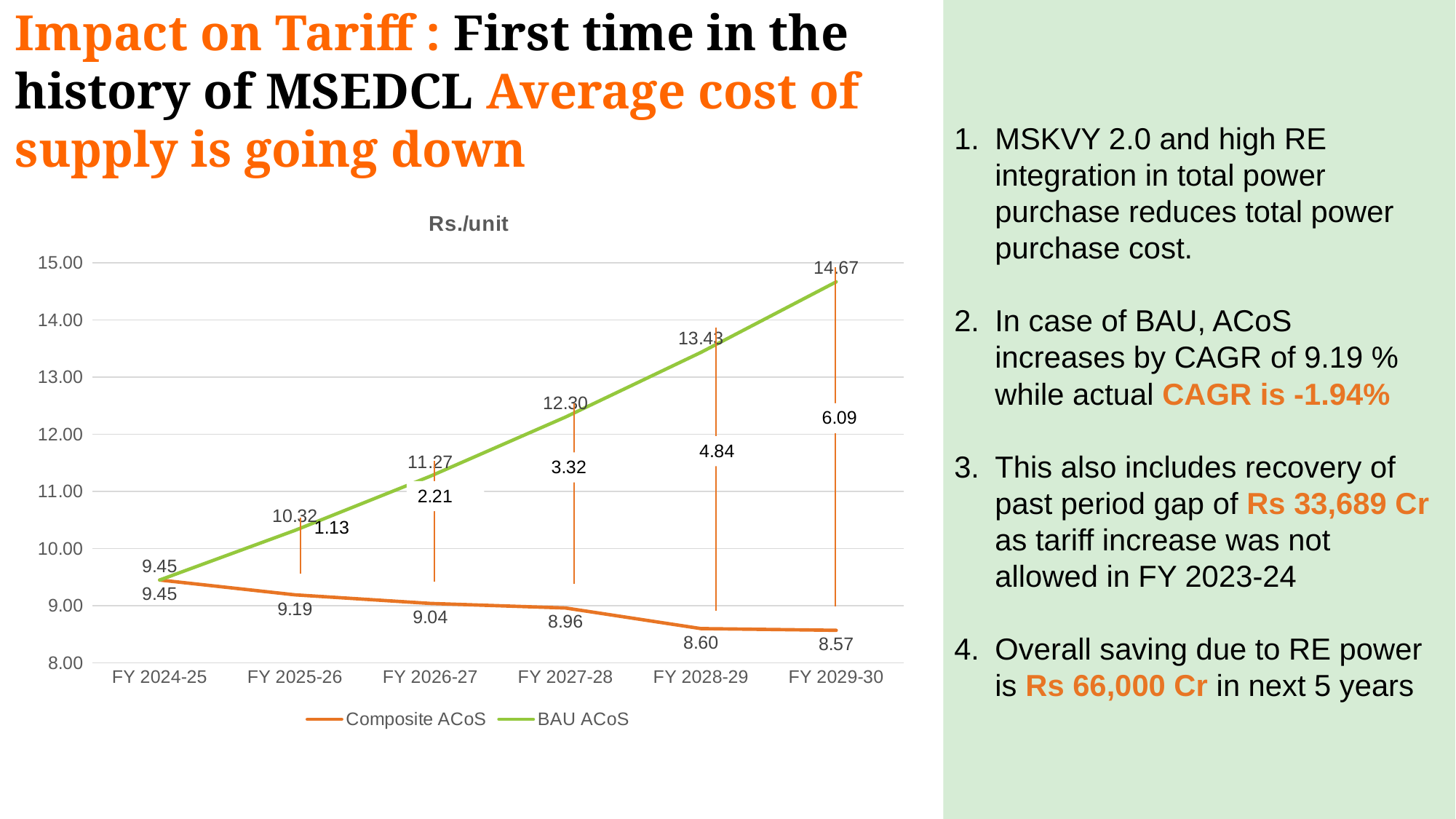
Does the Composite ACoS rise or fall from FY 2024-25 to FY 2029-30? Fall What is the BAU ACoS value for FY 2029-30? 14.67 Which is larger in FY 2025-26, the BAU ACoS or the Composite ACoS? BAU ACoS What is the BAU ACoS value for FY 2026-27? 11.27 How many series does the legend list? 2 What is the difference between BAU ACoS and Composite ACoS in FY 2028-29? 4.83 What kind of chart is shown on the slide? Line chart What unit is given in the chart title? Rs./unit What is the Composite ACoS value for FY 2027-28? 8.96 In which fiscal year is the Composite ACoS lowest? FY 2029-30 How many fiscal years are shown on the x axis? 6 In which fiscal year is the BAU ACoS highest? FY 2029-30